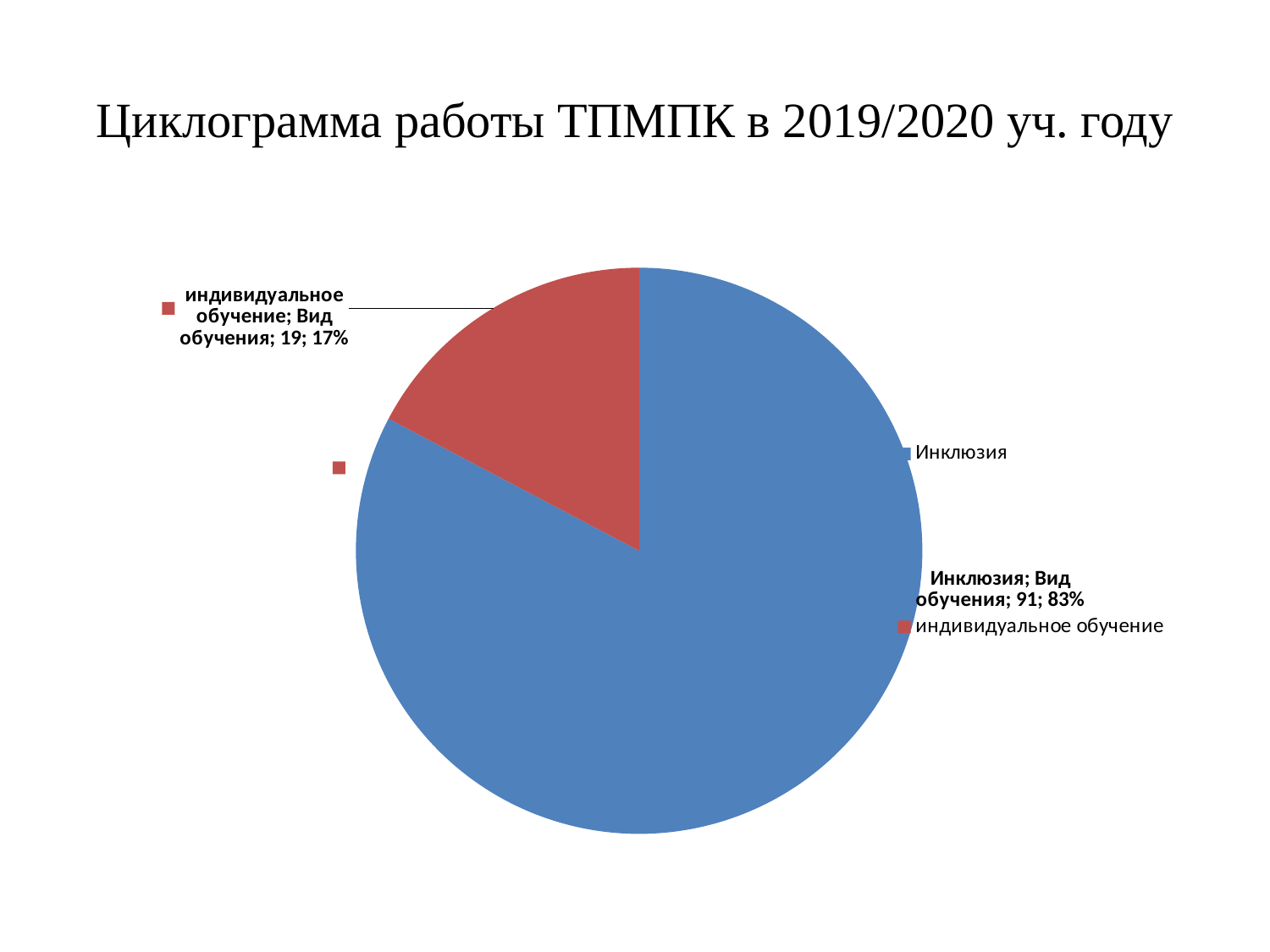
What is the value for Инклюзия? 91 What is the value for индивидуальное обучение? 19 What is the difference between the values for Инклюзия and индивидуальное обучение? 72 Which category has the largest slice? Инклюзия What colour is the slice for индивидуальное обучение? red How many slices does the pie chart have? 2 What kind of chart is shown on the slide? pie chart What is the total of the two slice values? 110 Which category has the smallest slice? индивидуальное обучение Which is larger, the value for Инклюзия or for индивидуальное обучение? Инклюзия What share of the pie does индивидуальное обучение take? 17% What share of the pie does Инклюзия take? 83%